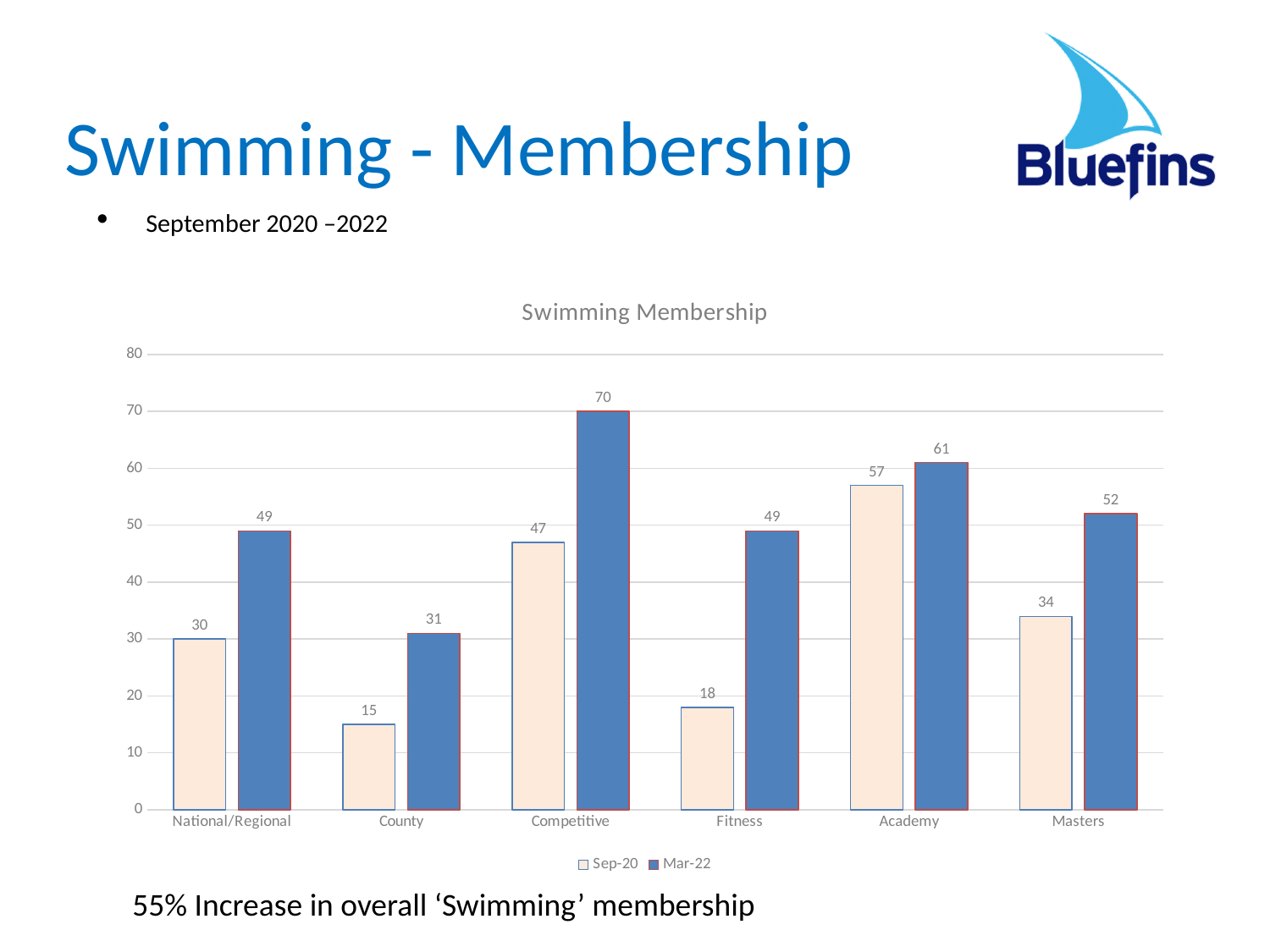
Is the Mar-22 value for Academy greater or less than 60? greater How many categories are shown on the x axis? 6 Which category has the highest Mar-22 value? Competitive Which category has the lowest Sep-20 value? County What is the difference between the Mar-22 and Sep-20 values for Fitness? 31 What is the title of the chart? Swimming Membership What kind of chart is shown? Bar chart What is the Sep-20 value for County? 15 How many series does the legend list? 2 What is the Mar-22 value for Competitive? 70 What is the Sep-20 value for Academy? 57 Which is larger: the Sep-20 value for Masters or the Sep-20 value for National/Regional? Masters